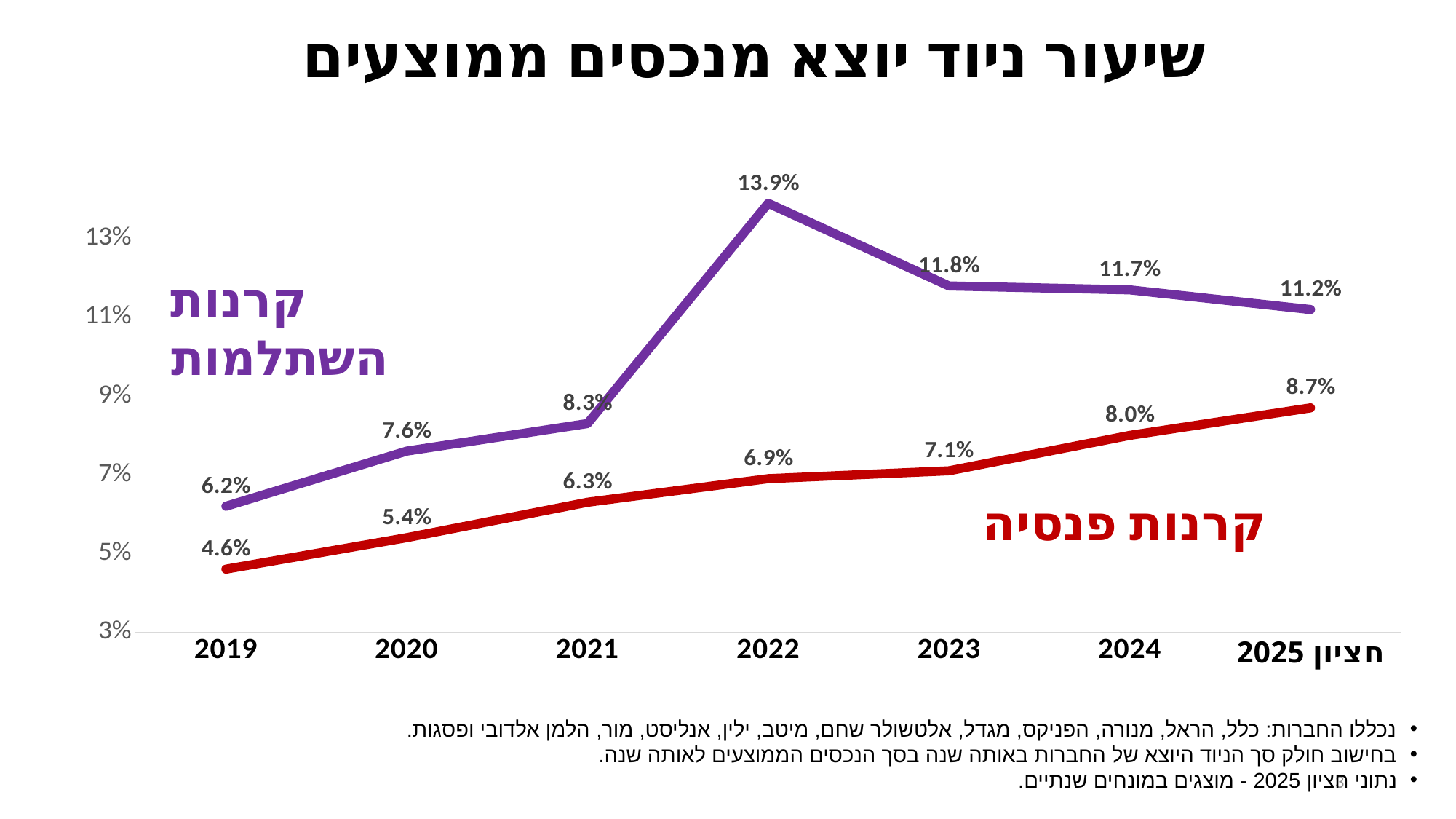
What is the value for קרנות פנסיה (the red line) in 2019? 4.6% What colour is the line for קרנות פנסיה? red Does the קרנות פנסיה (red) line rise or fall from 2019 to חציון 2025? rise What is the value for קרנות פנסיה (the red line) at חציון 2025? 8.7% What is the difference between the קרנות השתלמות and קרנות פנסיה values in 2022? 7.0% What type of chart is shown on the slide? line chart In which year does the קרנות השתלמות (purple) line reach its highest value? 2022 How many time points are plotted along the x axis? 7 Which series has the higher value in 2023, קרנות השתלמות or קרנות פנסיה? קרנות השתלמות How many series are plotted on the chart? 2 What is the value for קרנות השתלמות (the purple line) in 2022? 13.9% In which year is the קרנות פנסיה (red) line at its lowest value? 2019